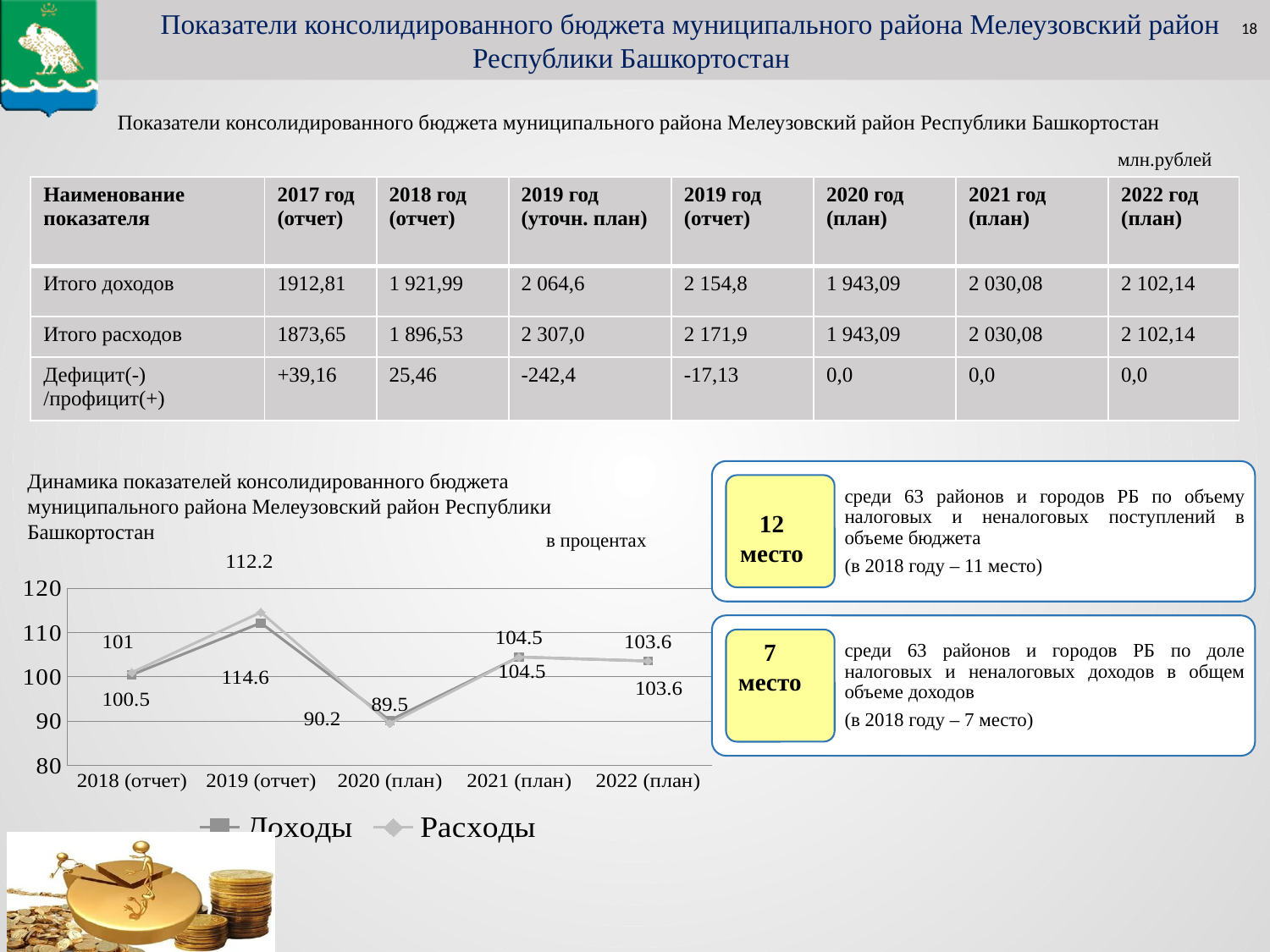
For 2019 (отчет), which is larger: Доходы or Расходы? Расходы What is the difference between Расходы and Доходы for 2019 (отчет)? 2.4 What kind of chart is shown on the slide? line chart What are the two entries in the chart legend? Доходы and Расходы How many categories are shown along the x axis of the chart? 5 How many series does the chart legend list? 2 In which category does Доходы have its lowest value? 2020 (план) What is the value of Расходы for 2022 (план)? 103.6 What is the value of Доходы for 2019 (отчет)? 112.2 In which category does Расходы reach its highest value? 2019 (отчет) What is the value of Расходы for 2019 (отчет)? 114.6 What is the value of Доходы for 2020 (план)? 90.2